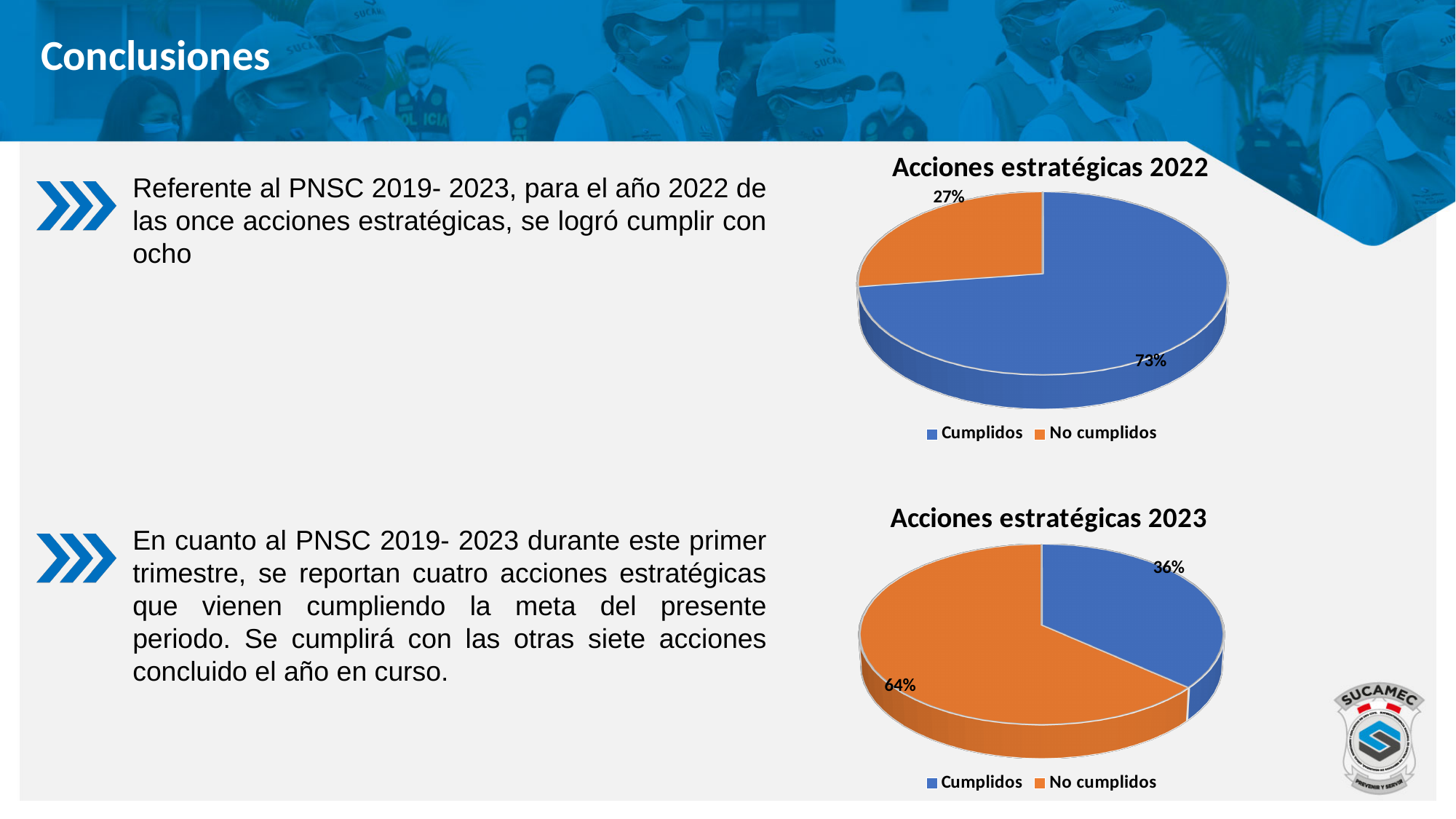
Which is larger: Cumplidos in the 'Acciones estratégicas 2022' chart or Cumplidos in the 'Acciones estratégicas 2023' chart? Acciones estratégicas 2022 In the 'Acciones estratégicas 2023' chart, what is the difference in percentage points between No cumplidos and Cumplidos? 28 In the 'Acciones estratégicas 2022' chart, what is the difference in percentage points between Cumplidos and No cumplidos? 46 How many categories does the 'Acciones estratégicas 2022' chart show? 2 In the 'Acciones estratégicas 2022' chart, what percentage is shown for Cumplidos? 73% In the 'Acciones estratégicas 2023' chart, what colour represents No cumplidos? Orange In the 'Acciones estratégicas 2023' chart, what percentage is shown for No cumplidos? 64% In the 'Acciones estratégicas 2023' chart, which category has the smallest slice? Cumplidos In the 'Acciones estratégicas 2022' chart, which category has the largest slice? Cumplidos What type of chart is 'Acciones estratégicas 2023'? Pie chart In the 'Acciones estratégicas 2022' chart, what percentage is shown for No cumplidos? 27% In the 'Acciones estratégicas 2023' chart, what percentage is shown for Cumplidos? 36%